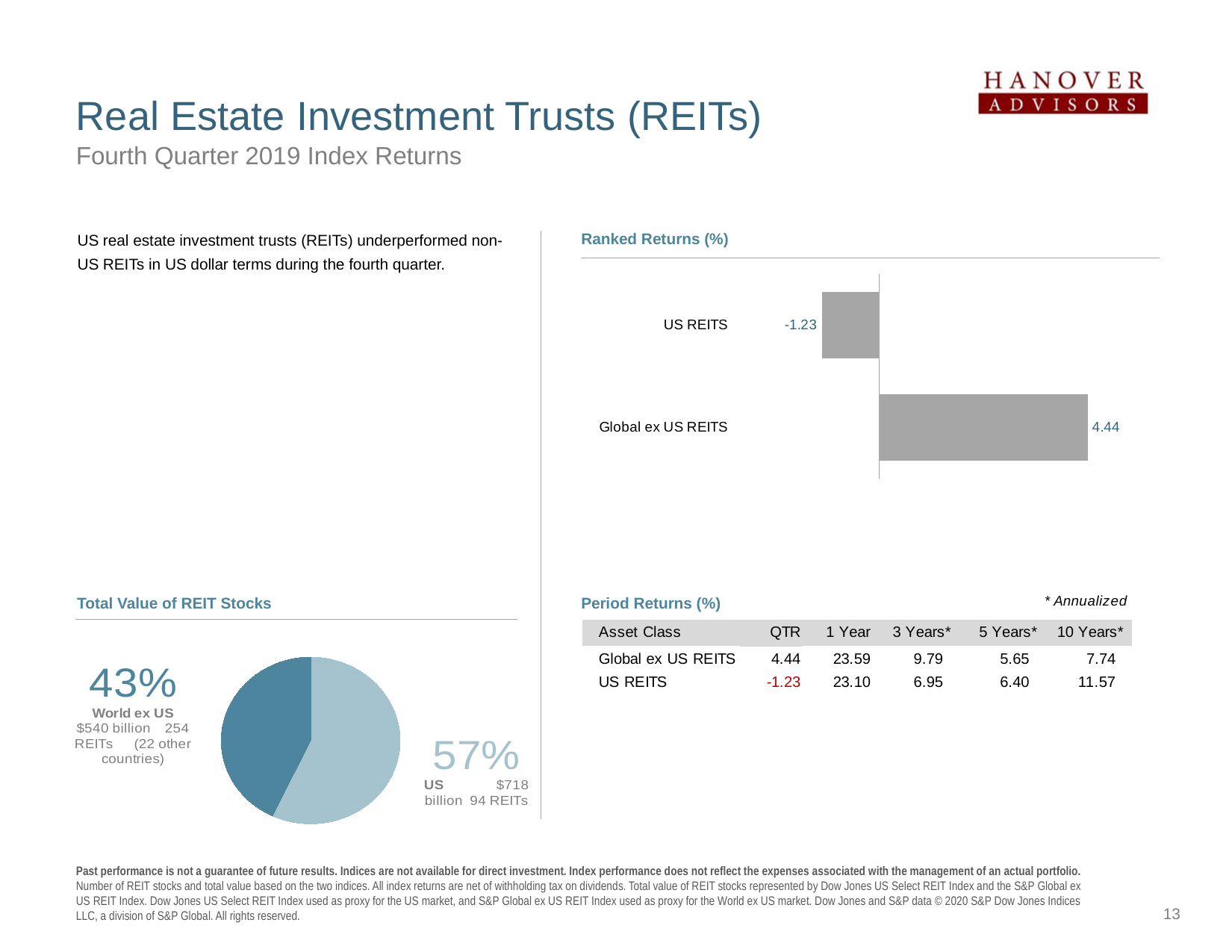
In the Ranked Returns (%) chart, which category has the highest value? Global ex US REITS In the Ranked Returns (%) chart, how many categories are plotted? 2 In the Total Value of REIT Stocks chart, how many slices does the pie have? 2 In the Total Value of REIT Stocks chart, what share of the pie is US? 57% What kind of chart is the Total Value of REIT Stocks chart? Pie chart In the Total Value of REIT Stocks chart, which slice is larger, US or World ex US? US In the Ranked Returns (%) chart, what is the value for US REITS? -1.23 In the Ranked Returns (%) chart, what is the value for Global ex US REITS? 4.44 In the Total Value of REIT Stocks chart, what share of the pie is World ex US? 43% In the Ranked Returns (%) chart, what is the difference between the Global ex US REITS value and the US REITS value? 5.67 In the Ranked Returns (%) chart, which category has the lowest value? US REITS What kind of chart is the Ranked Returns (%) chart? Bar chart